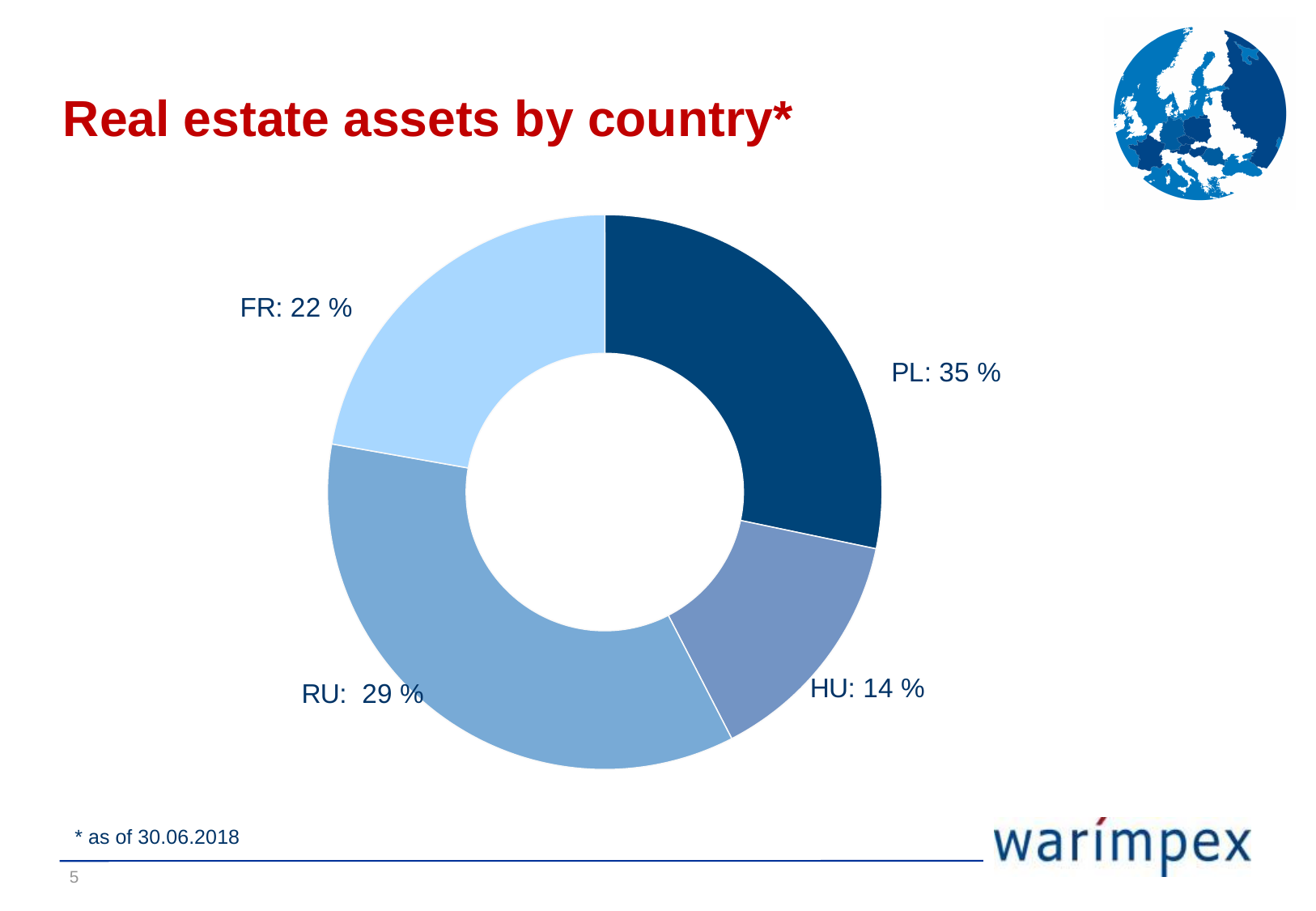
Which country has the smallest share of real estate assets? HU Which country has the largest share of real estate assets? PL What kind of chart is shown on the slide? Doughnut (pie) chart What share of real estate assets is in FR? 22 % What share of real estate assets is in HU? 14 % What share of real estate assets is in PL? 35 % Which has a larger share of real estate assets, RU or FR? RU How many countries are shown in the chart? 4 What is the difference in percentage points between the RU and FR shares? 7 What share of real estate assets is in RU? 29 % What is the title of the chart on the slide? Real estate assets by country* What is the difference in percentage points between the PL and HU shares? 21